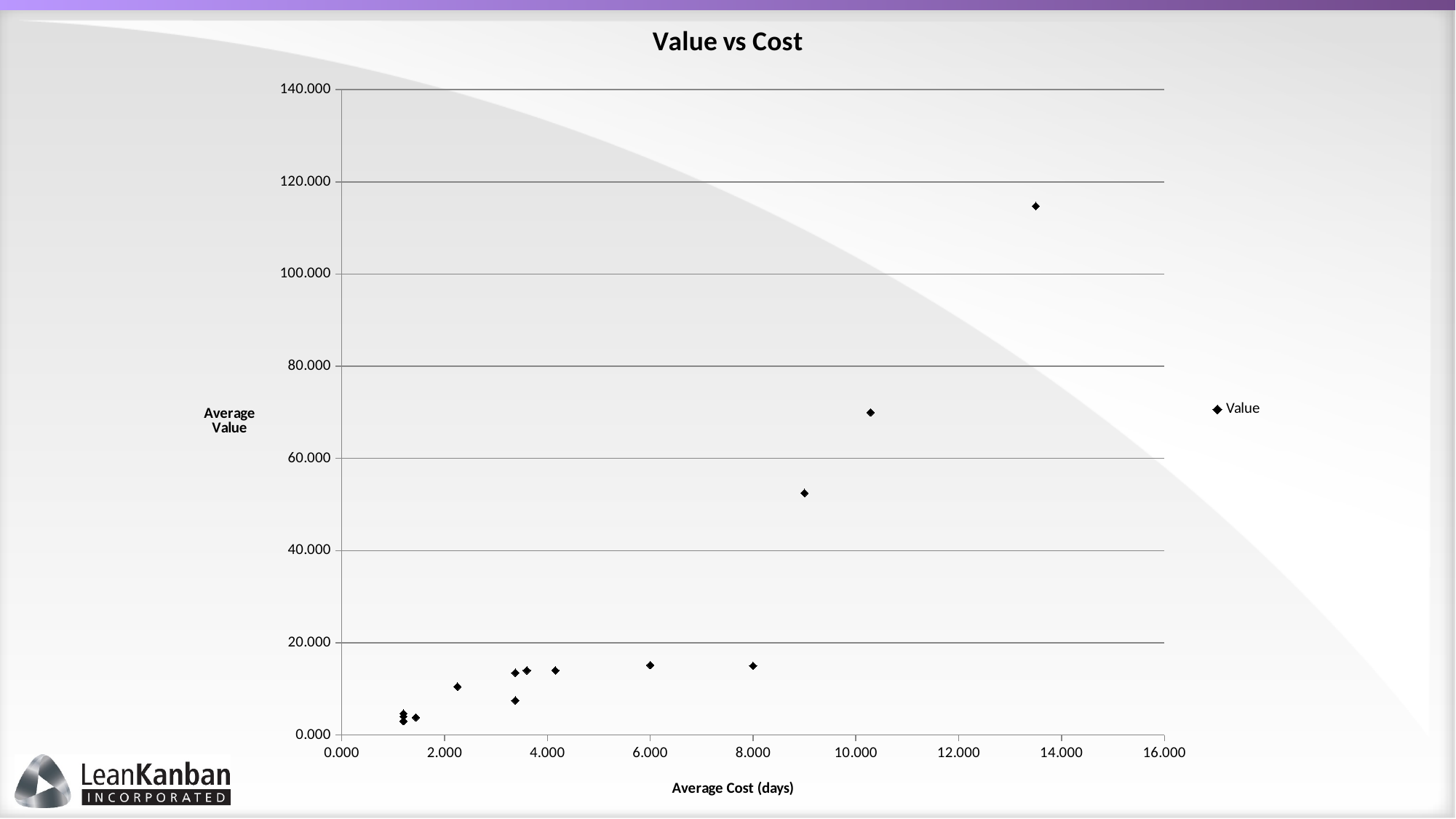
Is the Average Value of the point at roughly 10.000 days of Average Cost greater or less than 80.000? less What is the title of the chart? Value vs Cost What kind of chart is shown on the slide? scatter chart What is the highest tick value shown on the y axis? 140.000 What is the label of the x axis? Average Cost (days) Do the Average Value points generally rise or fall as Average Cost increases? rise Which has the higher Average Value: the point at about 13.500 days or the point at about 10.000 days of Average Cost? the point at about 13.500 days Is the highest plotted point's Average Value greater or less than 100.000? greater Is the Average Value of the point at roughly 9.000 days of Average Cost greater or less than 40.000? greater How many series does the legend list? 1